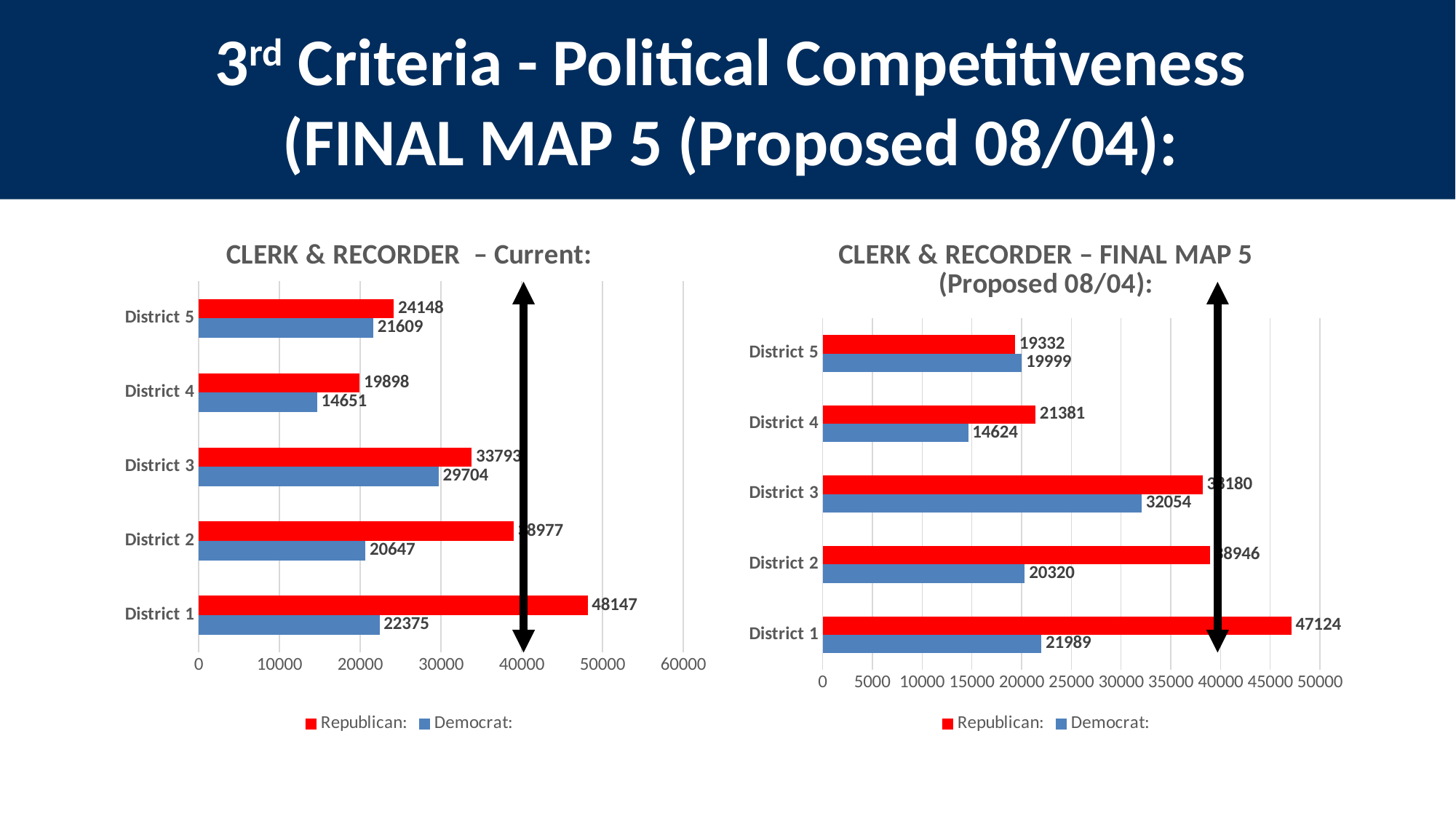
In the CLERK & RECORDER – FINAL MAP 5 chart, what is the difference between the Republican and Democrat values for District 1? 25135 What type of chart is the CLERK & RECORDER – FINAL MAP 5 chart? Bar chart In the CLERK & RECORDER – Current chart, which district has the highest Republican value? District 1 In the CLERK & RECORDER – Current chart, what is the Democrat value for District 4? 14651 In the CLERK & RECORDER – FINAL MAP 5 chart, what is the Democrat value for District 5? 19999 In the CLERK & RECORDER – FINAL MAP 5 chart, is the Republican or Democrat value larger for District 5? Democrat How many series does the legend list in the CLERK & RECORDER – Current chart? 2 In the CLERK & RECORDER – Current chart, what is the difference between the Republican and Democrat values for District 3? 4089 In the CLERK & RECORDER – Current chart, is the Democrat value for District 2 greater or less than 30000? less In the CLERK & RECORDER – Current chart, what is the Republican value for District 1? 48147 In the CLERK & RECORDER – FINAL MAP 5 chart, what is the Republican value for District 4? 21381 In the CLERK & RECORDER – FINAL MAP 5 chart, which district has the lowest Democrat value? District 4